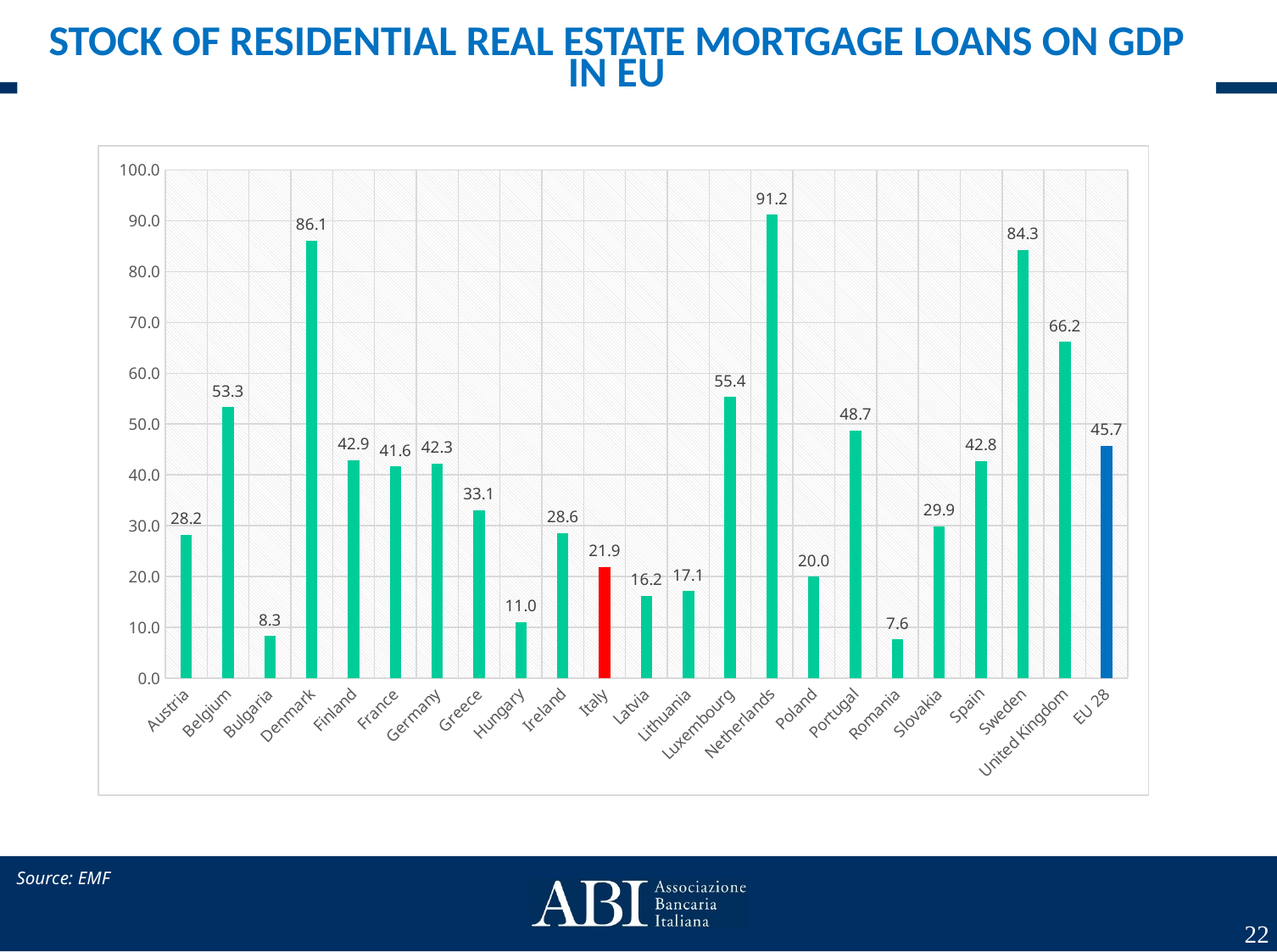
How many categories are shown on the x axis? 23 What is the value for EU 28? 45.7 What kind of chart is shown on the slide? bar chart What is the difference between the value for EU 28 and the value for Italy? 23.8 What is the value for Denmark? 86.1 Which country has the lowest value? Romania Which bar is coloured red? Italy Which country has the highest value? Netherlands Which is larger, the value for Sweden or the value for United Kingdom? Sweden What is the value for Italy? 21.9 Is the value for Luxembourg greater or less than 50.0? greater What is the difference between the value for Netherlands and the value for Italy? 69.3